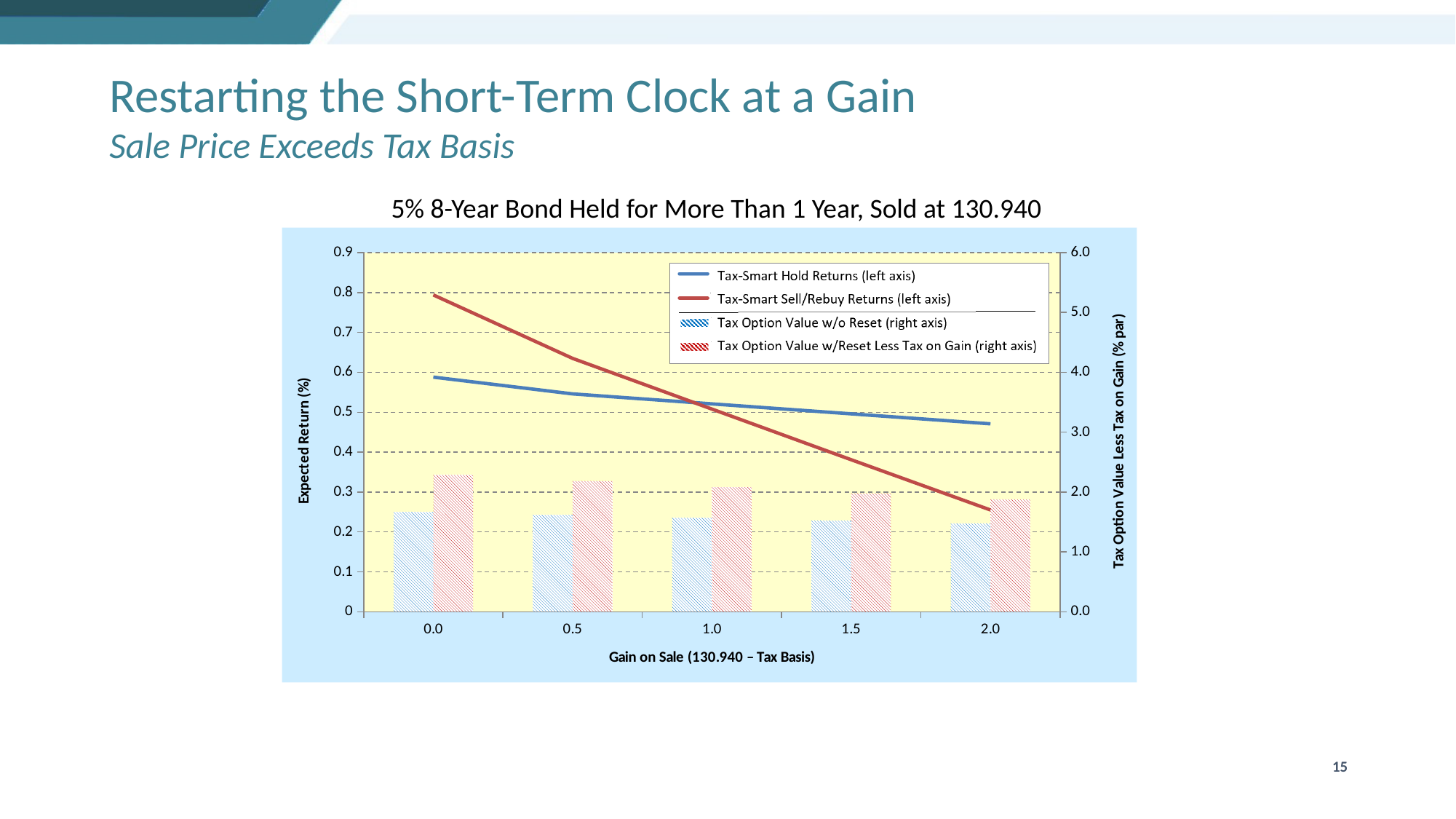
At a Gain on Sale of 2.0, which line is higher: Tax-Smart Hold Returns or Tax-Smart Sell/Rebuy Returns? Tax-Smart Hold Returns Is the Tax Option Value w/Reset Less Tax on Gain bar at a Gain on Sale of 0.0 greater or less than 2.0 on the right axis? greater Does the Tax-Smart Hold Returns line rise or fall as Gain on Sale increases? Fall Is the Tax-Smart Sell/Rebuy Returns value at a Gain on Sale of 2.0 greater or less than 0.3? less Does the Tax-Smart Sell/Rebuy Returns line rise or fall as Gain on Sale increases? Fall At a Gain on Sale of 0.0, which line is higher: Tax-Smart Hold Returns or Tax-Smart Sell/Rebuy Returns? Tax-Smart Sell/Rebuy Returns How many Gain on Sale values are shown along the x axis? 5 What kind of chart is shown on the slide? A combination line and bar chart Is the Tax-Smart Sell/Rebuy Returns value at a Gain on Sale of 0.0 greater or less than 0.7? greater What is the title of the chart? 5% 8-Year Bond Held for More Than 1 Year, Sold at 130.940 How many series does the legend list? 4 At a Gain on Sale of 0.0, which bar is taller: Tax Option Value w/o Reset or Tax Option Value w/Reset Less Tax on Gain? Tax Option Value w/Reset Less Tax on Gain